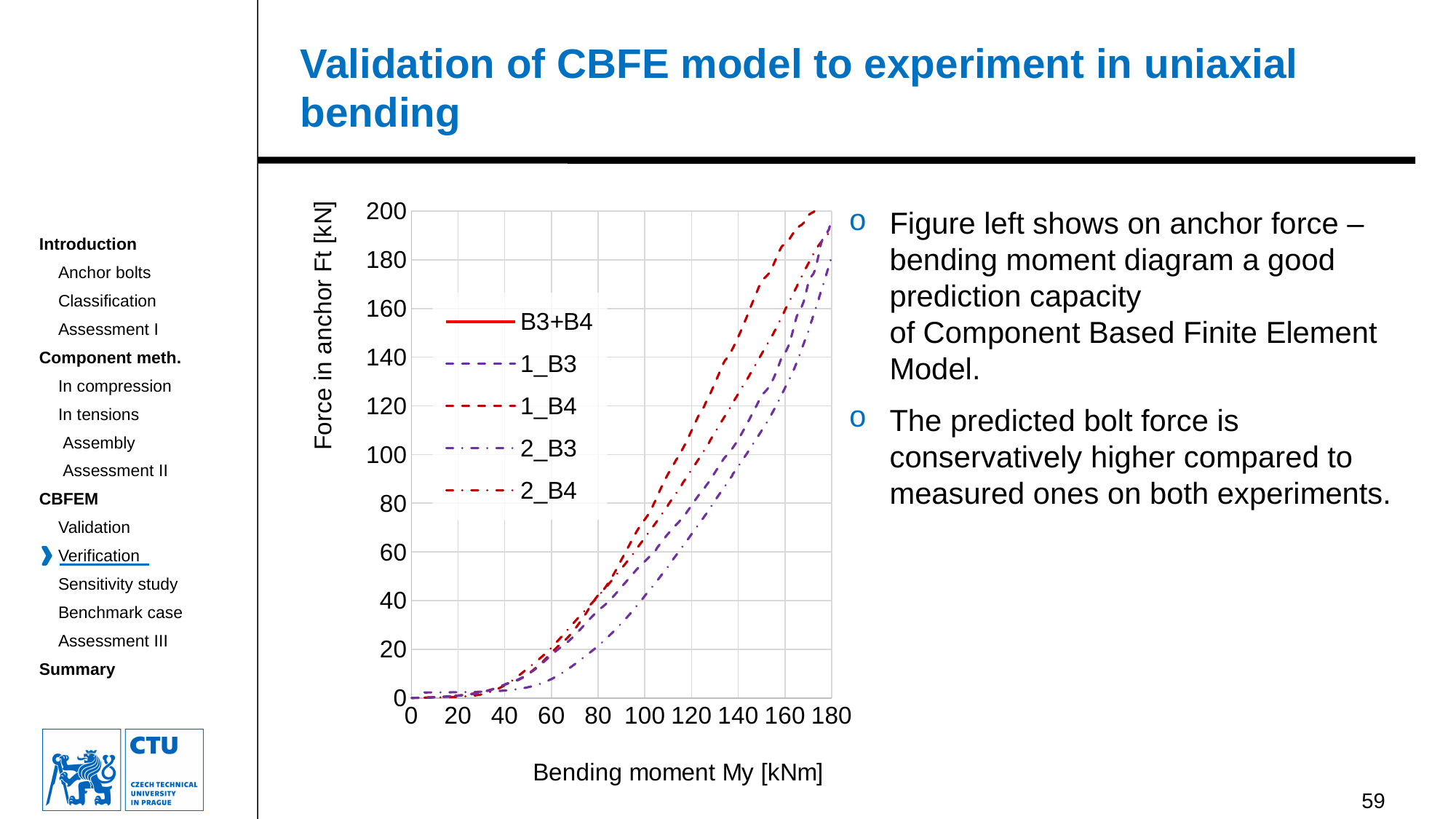
What kind of chart is shown on the slide? line chart How many series does the chart legend list? 5 What is the label of the x axis of the chart? Bending moment My [kNm] At a bending moment of 100 kNm, which series has the larger force, 1_B4 or 2_B3? 1_B4 Is the value of the 1_B4 series at a bending moment of 160 kNm greater or less than 160 kN? greater Is the value of the 2_B3 series at a bending moment of 100 kNm greater or less than 60 kN? less At a bending moment of 100 kNm, which series has the lowest force in anchor? 2_B3 Is the value of the 2_B3 series at a bending moment of 60 kNm greater or less than 20 kN? less Do the values of the 1_B4 series rise or fall as the bending moment increases along the x axis? rise What is the label of the y axis of the chart? Force in anchor Ft [kN] Which series reaches the highest force in anchor on the chart? 1_B4